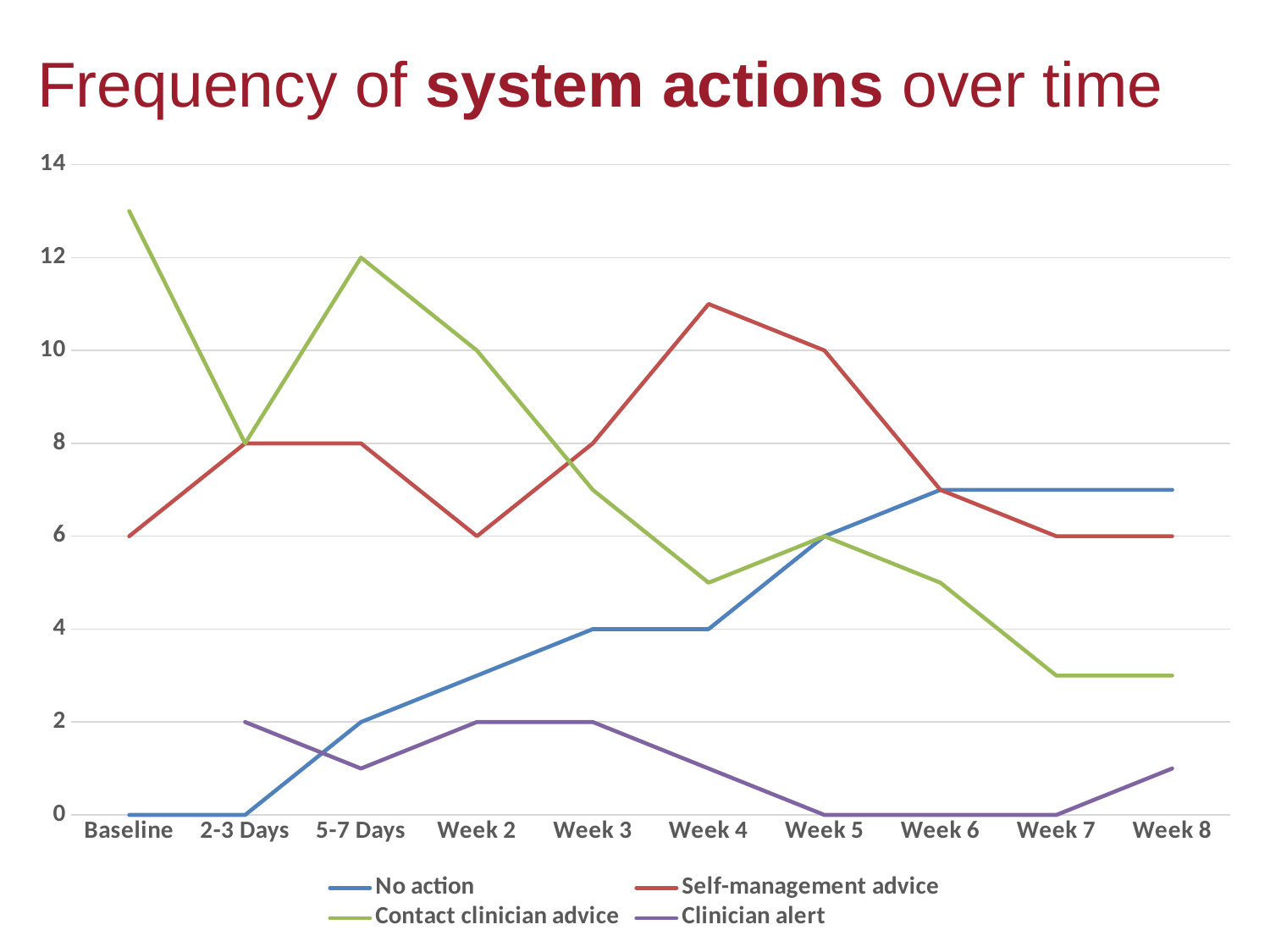
How many series does the legend list? 4 What is the value for Self-management advice at Week 5? 10 How many time points are shown along the x axis? 10 What is the value for Clinician alert at Week 5? 0 What is the value for Contact clinician advice at 5-7 Days? 12 What is the difference between the Contact clinician advice values at 5-7 Days and Week 2? 2 Is the value for Contact clinician advice at Baseline greater or less than 12? greater What is the value for No action at Baseline? 0 At which time point does Self-management advice reach its highest value? Week 4 Which series has the highest value at Baseline? Contact clinician advice What kind of chart is shown on the slide? line chart Is the value for Contact clinician advice at Week 8 greater or less than 4? less